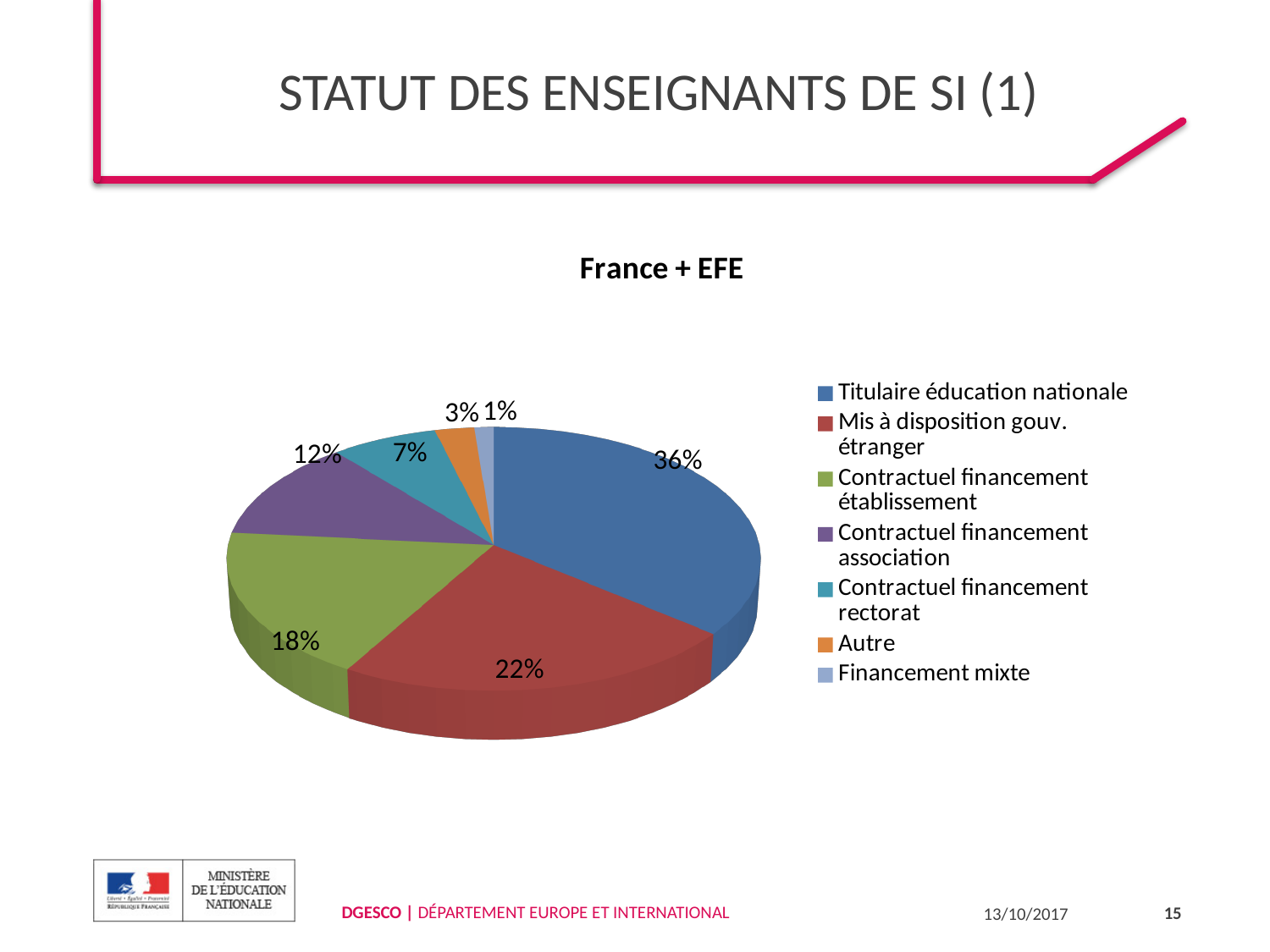
What share of the pie does "Mis à disposition gouv. étranger" have? 22% What share of the pie does "Contractuel financement association" have? 12% What share of the pie does "Autre" have? 3% Which category has the smallest slice of the pie? Financement mixte What kind of chart is shown on the slide? pie chart How many categories does the legend list? 7 What is the difference between the shares of "Titulaire éducation nationale" and "Mis à disposition gouv. étranger"? 14% Which category has the largest slice of the pie? Titulaire éducation nationale What is the chart's title? France + EFE